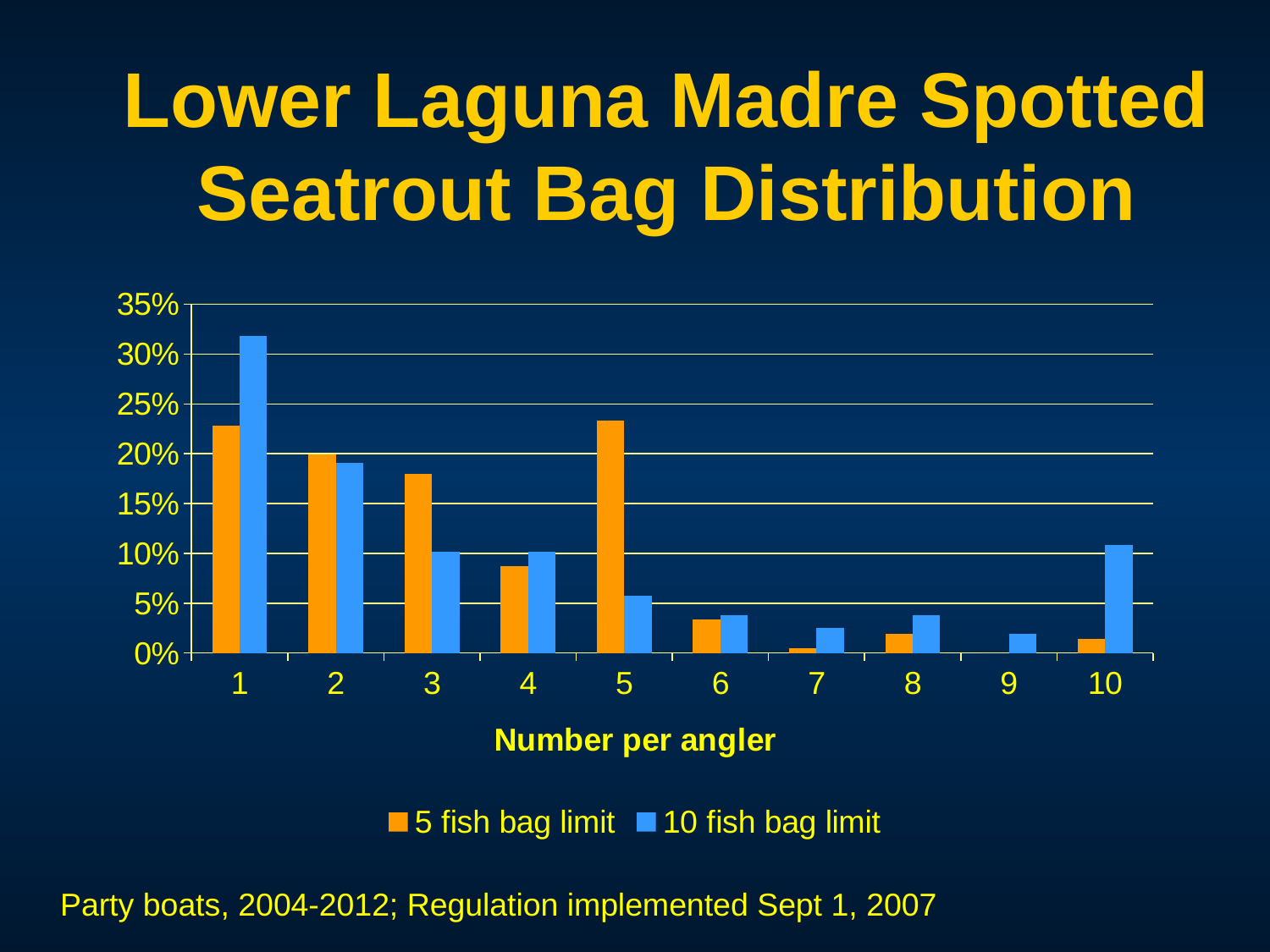
At 10 fish per angler, which series has the larger value, 5 fish bag limit or 10 fish bag limit? 10 fish bag limit How many categories are shown on the x axis? 10 What kind of chart is shown on the slide? bar chart How many series does the legend list? 2 Is the 5 fish bag limit value for 5 fish per angler greater or less than 20%? greater Is the 10 fish bag limit value for 1 fish per angler greater or less than 30%? greater Do the 10 fish bag limit values rise or fall from 1 to 5 fish per angler? fall Is the 10 fish bag limit value for 3 fish per angler greater or less than 15%? less At 5 fish per angler, which series has the larger value, 5 fish bag limit or 10 fish bag limit? 5 fish bag limit For the 10 fish bag limit series, which number per angler has the highest value? 1 What is the title of the x axis? Number per angler